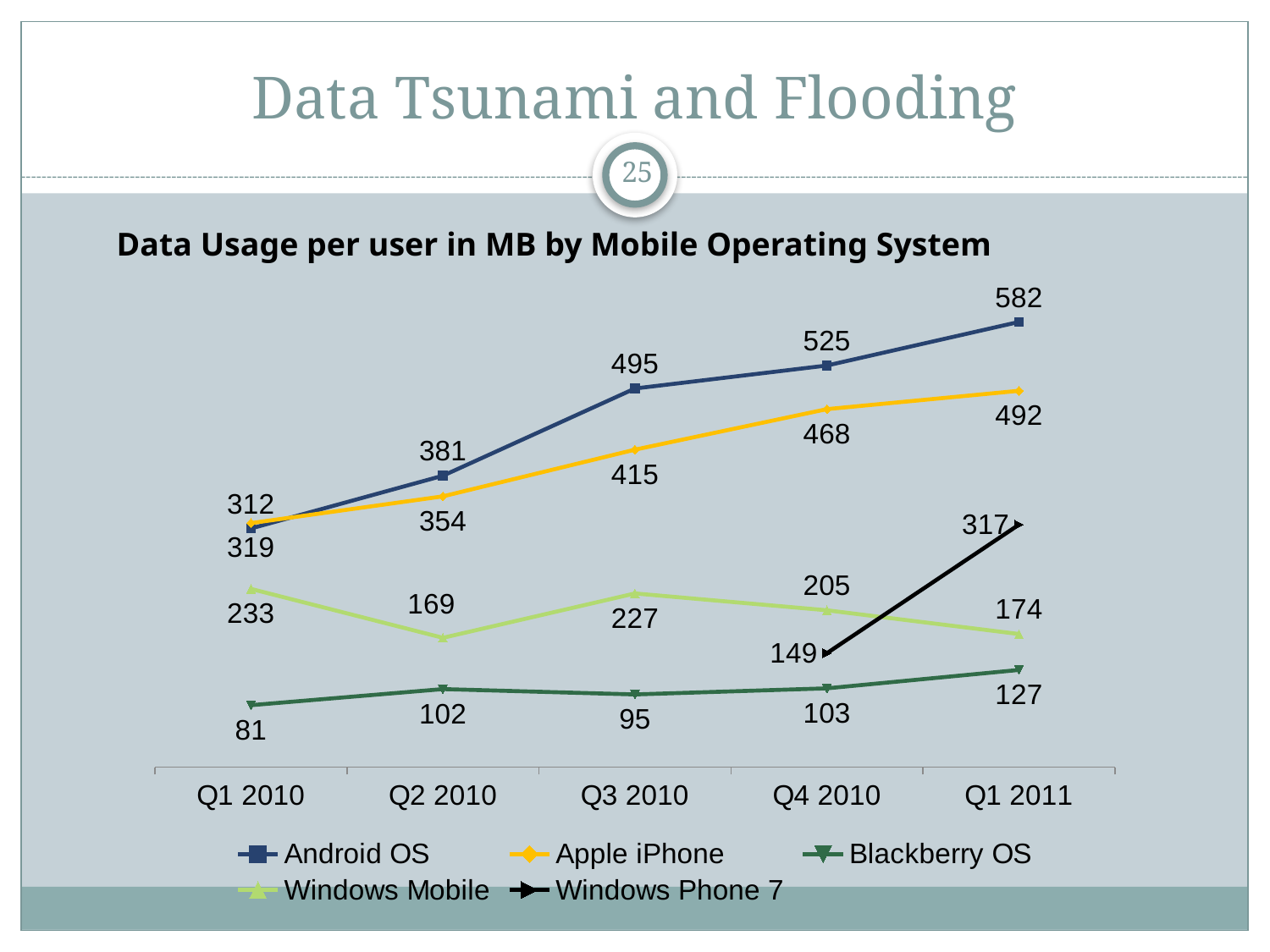
What is the value for Blackberry OS in Q1 2010? 81 What is the value for Windows Mobile in Q2 2010? 169 How many series does the legend list? 5 What is the value for Windows Phone 7 in Q4 2010? 149 What kind of chart is shown on the slide? Line chart By how much did Windows Phone 7 increase from Q4 2010 to Q1 2011? 168 How many quarters are shown on the x axis? 5 Which operating system has the lowest data usage per user in Q3 2010? Blackberry OS What is the data usage per user for Android OS in Q1 2011? 582 Which is larger for Windows Mobile: the value in Q1 2010 or the value in Q3 2010? Q1 2010 What is the difference between Android OS and Apple iPhone in Q1 2011? 90 Which operating system has the highest data usage per user in Q1 2011? Android OS